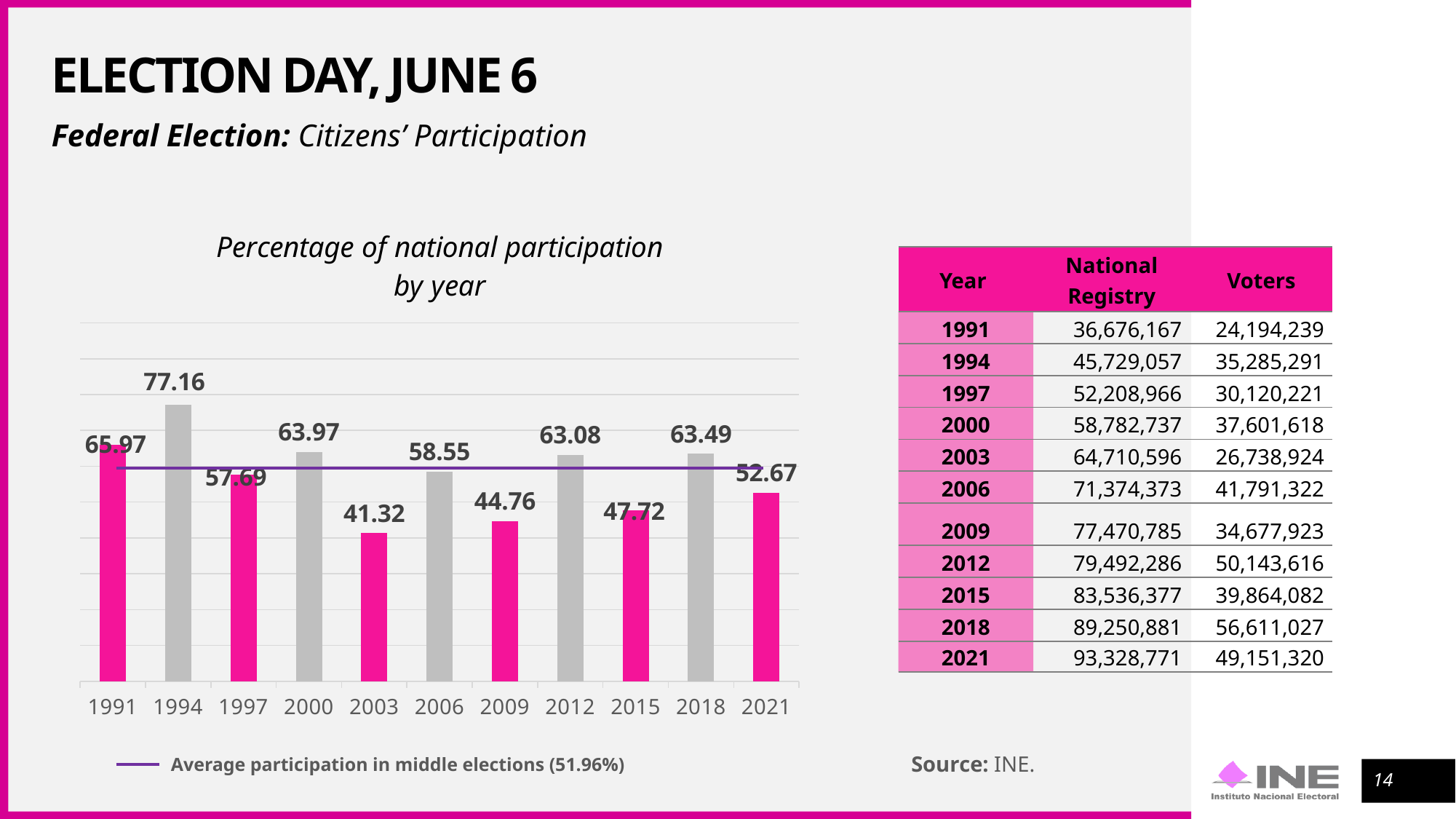
What is the percentage of national participation for 2021? 52.67 Which year has a higher participation percentage, 2009 or 2015? 2015 Which year has the highest percentage of national participation? 1994 Which year has the lowest percentage of national participation? 2003 What is the difference between the participation percentages for 1994 and 2003? 35.84 Which year has a higher participation percentage, 2000 or 2012? 2000 What is the percentage of national participation for 1994? 77.16 What type of chart is used to show the percentage of national participation by year? Bar chart What is the percentage of national participation for 2003? 41.32 What value does the legend give for the average participation in middle elections? 51.96% How many years are shown on the x axis of the chart? 11 What is the difference between the participation percentages for 2018 and 2021? 10.82